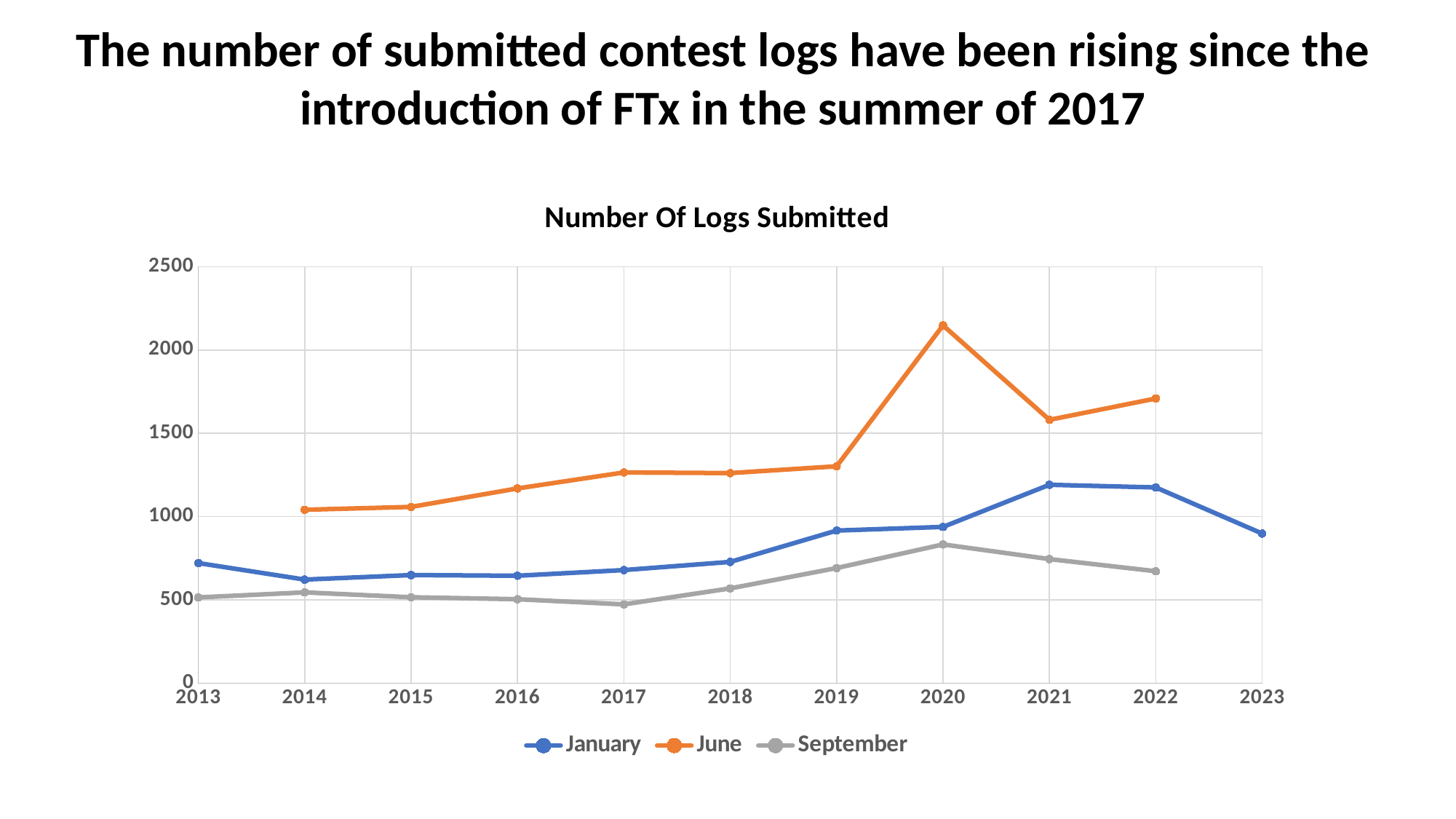
Which series has the larger value in 2021, January or June? June What kind of chart is shown on the slide? Line chart Is the September value for 2017 greater or less than 500? less How many series does the legend list? 3 How many years are shown along the x axis? 11 Does the June series rise or fall between 2014 and 2020? Rise Is the January value for 2019 greater or less than 1000? less Is the June value for 2020 greater or less than 2000? greater Which series has the larger value in 2020, January or September? January In which year does the June series reach its highest value? 2020 What is the title of the chart? Number Of Logs Submitted